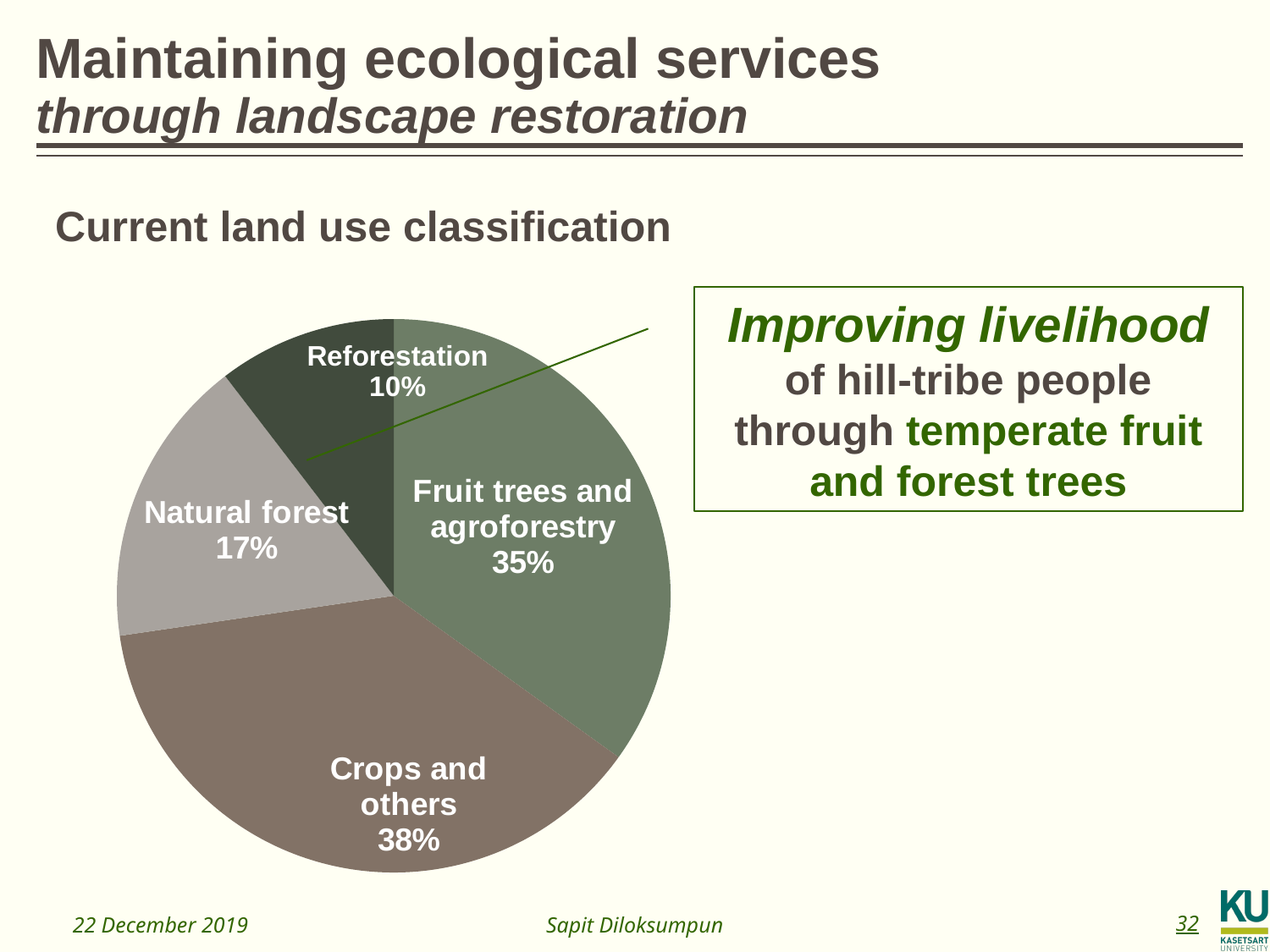
Which land use category has the largest share of the pie? Crops and others What is the difference between the shares for Natural forest and Reforestation? 7% What is the value shown for Fruit trees and agroforestry? 35% What is the value shown for Natural forest? 17% What is the value shown for Reforestation? 10% How many categories are shown in the pie chart? 4 What kind of chart is shown on the slide? Pie chart What is the heading above the chart? Current land use classification What is the difference between the shares for Crops and others and Fruit trees and agroforestry? 3% Which is larger, the share for Natural forest or the share for Reforestation? Natural forest Which land use category has the smallest share of the pie? Reforestation What share of the pie does Crops and others represent? 38%